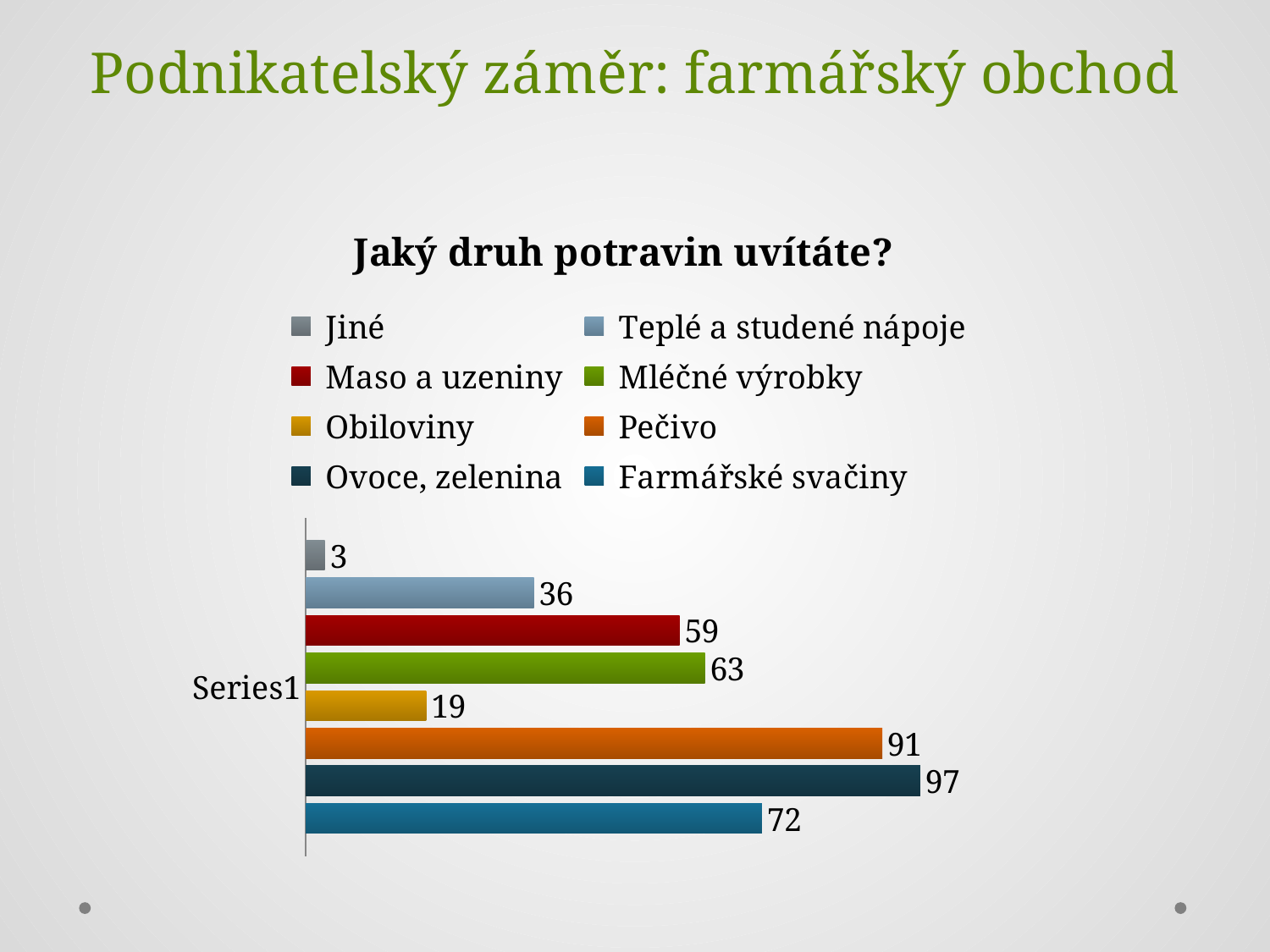
Which is larger, the value for Farmářské svačiny or the value for Mléčné výrobky? Farmářské svačiny What is the title of the chart? Jaký druh potravin uvítáte? What is the difference between the values for Mléčné výrobky and Maso a uzeniny? 4 Which legend entry has the lowest value? Jiné What is the difference between the values for Ovoce, zelenina and Pečivo? 6 What is the value for Pečivo? 91 How many series does the legend list? 8 What is the value for Obiloviny? 19 Which legend entry has the highest value? Ovoce, zelenina What is the value for Teplé a studené nápoje? 36 What is the value for Farmářské svačiny? 72 What kind of chart is shown on the slide? Bar chart